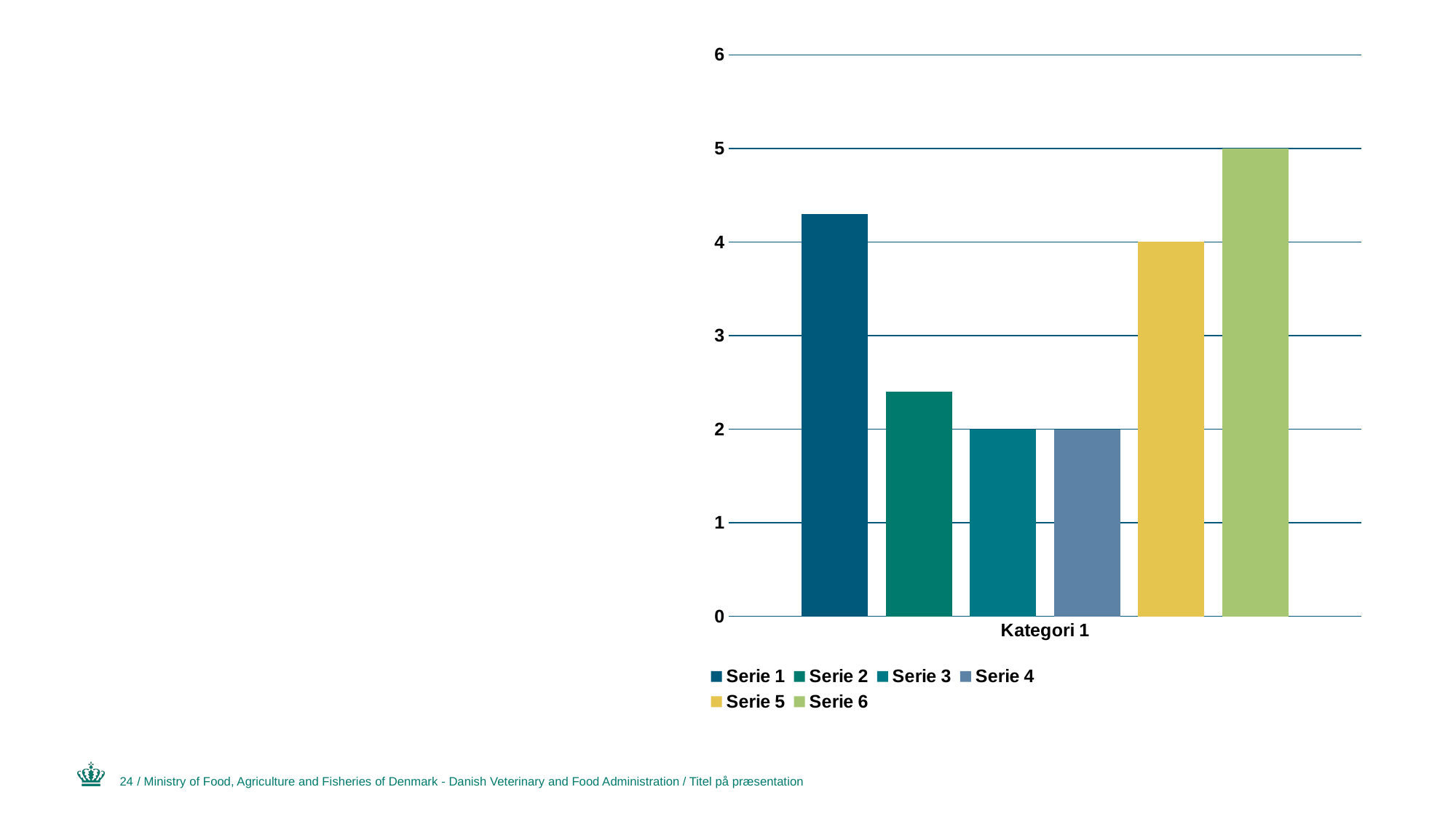
What is the difference between the values of Serie 6 and Serie 5? 1 Which series has the highest value for Kategori 1? Serie 6 What is the value of Serie 5 for Kategori 1? 4 What is the value of Serie 6 for Kategori 1? 5 How many series does the legend list? 6 What is the value of Serie 3 for Kategori 1? 2 What is the label of the category on the x axis? Kategori 1 How many categories are shown on the x axis? 1 Is the value for Serie 1 greater or less than 4? greater Is the value for Serie 2 greater or less than 3? less Which is larger for Kategori 1, Serie 1 or Serie 5? Serie 1 What kind of chart is shown on the slide? bar chart